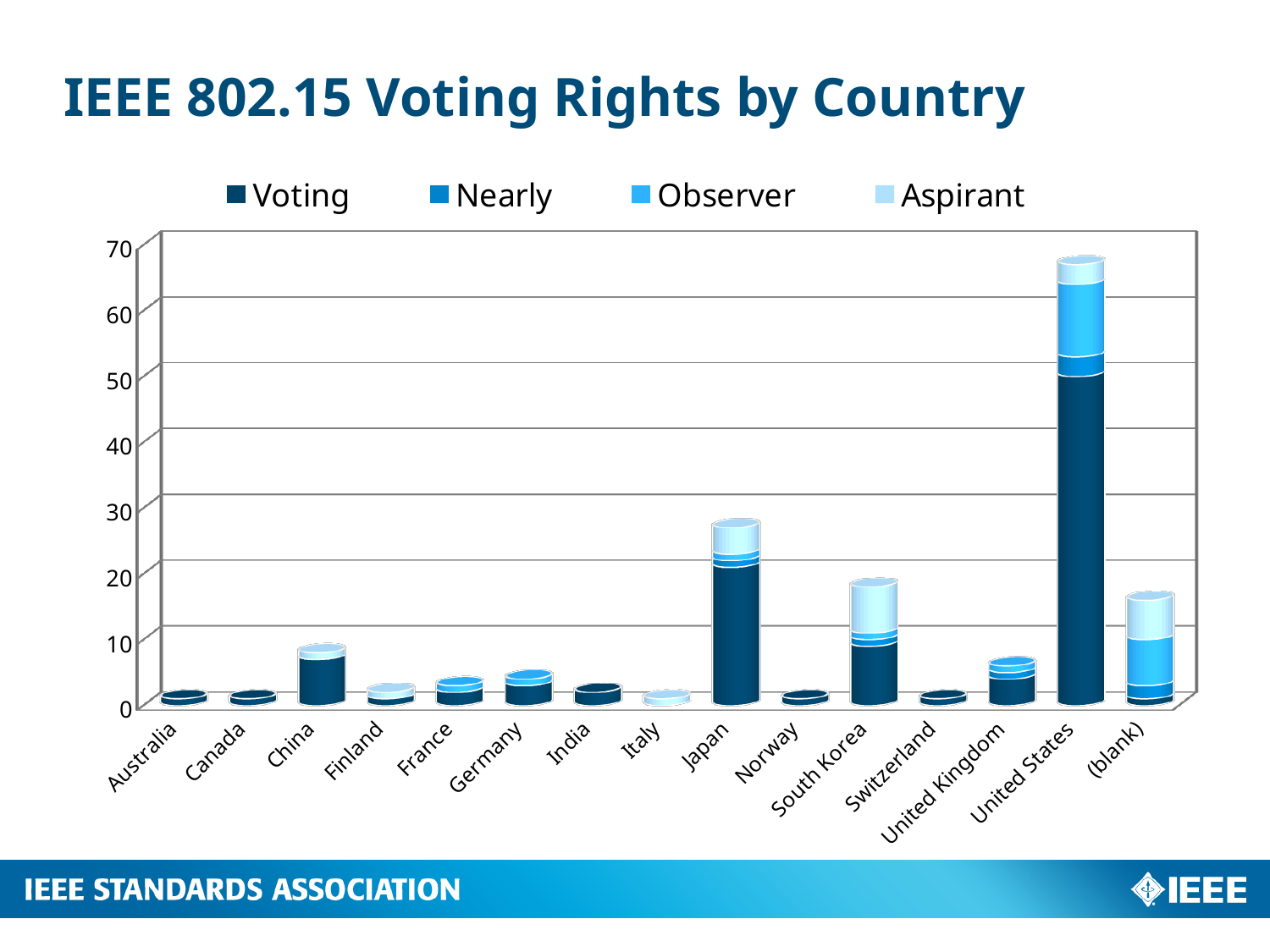
Which series is listed first in the legend? Voting What kind of chart is shown on the slide? bar chart How many countries (categories) are shown on the x axis? 15 How many series does the legend list? 4 Which has the taller stacked bar, China or Finland? China Is the total stacked value for Japan greater or less than 20? greater Is the total stacked value for United States greater or less than 60? greater Is the total stacked value for China greater or less than 10? less Which category has the tallest stacked bar? United States What is the title of the chart? IEEE 802.15 Voting Rights by Country Which has the taller stacked bar, Japan or South Korea? Japan